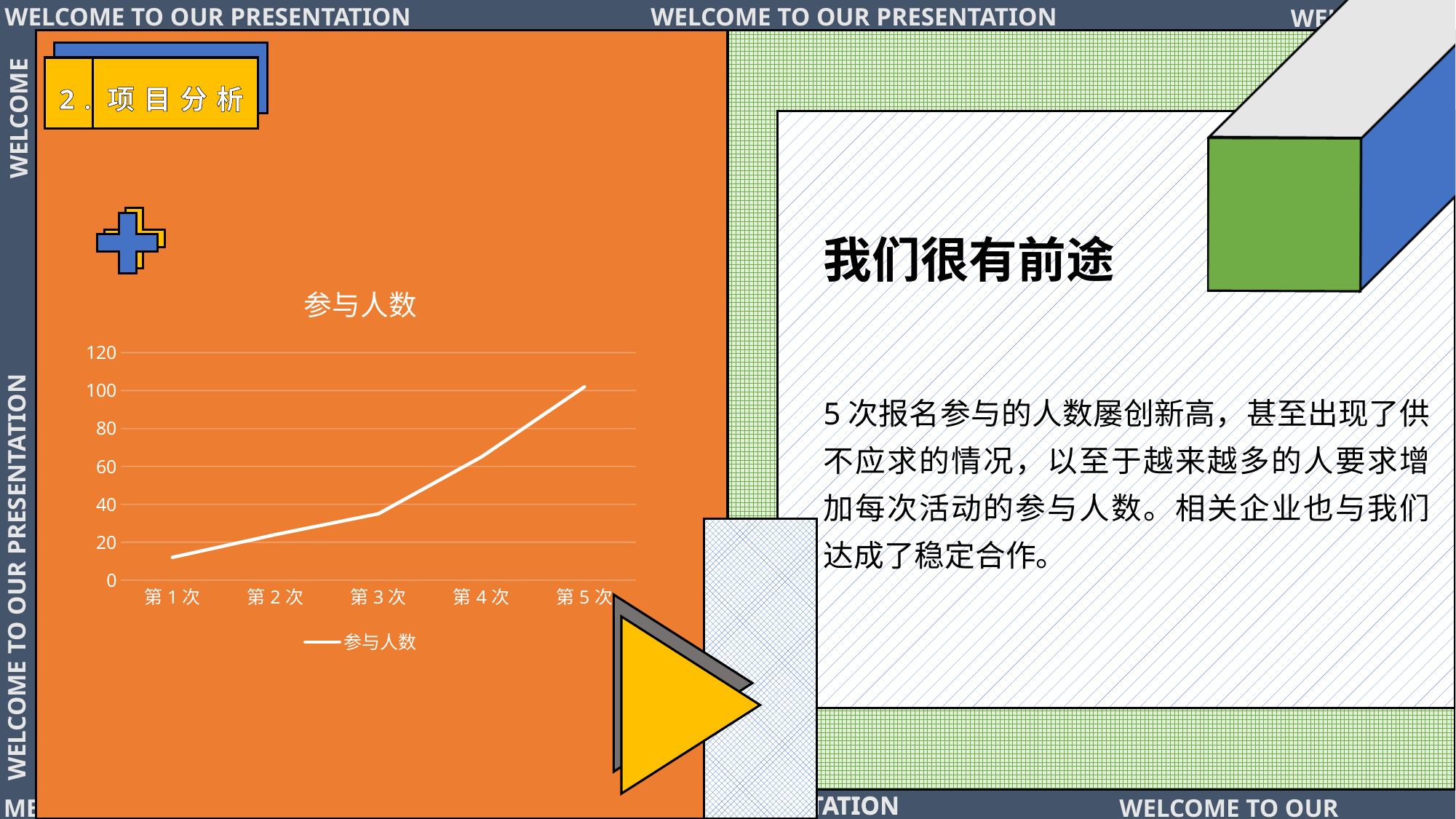
How many categories are plotted along the x axis of the chart? 5 Is the value for 第4次 greater or less than 40? greater What kind of chart is shown on the slide? line chart Is the value for 第5次 greater or less than 80? greater How many series does the chart's legend list? 1 Which category has the lowest value in the chart? 第1次 Is the value for 第2次 greater or less than 40? less What is the title of the chart? 参与人数 Do the values rise or fall from 第1次 to 第5次? rise Which is larger, the value for 第4次 or the value for 第2次? 第4次 Which category has the highest value in the chart? 第5次